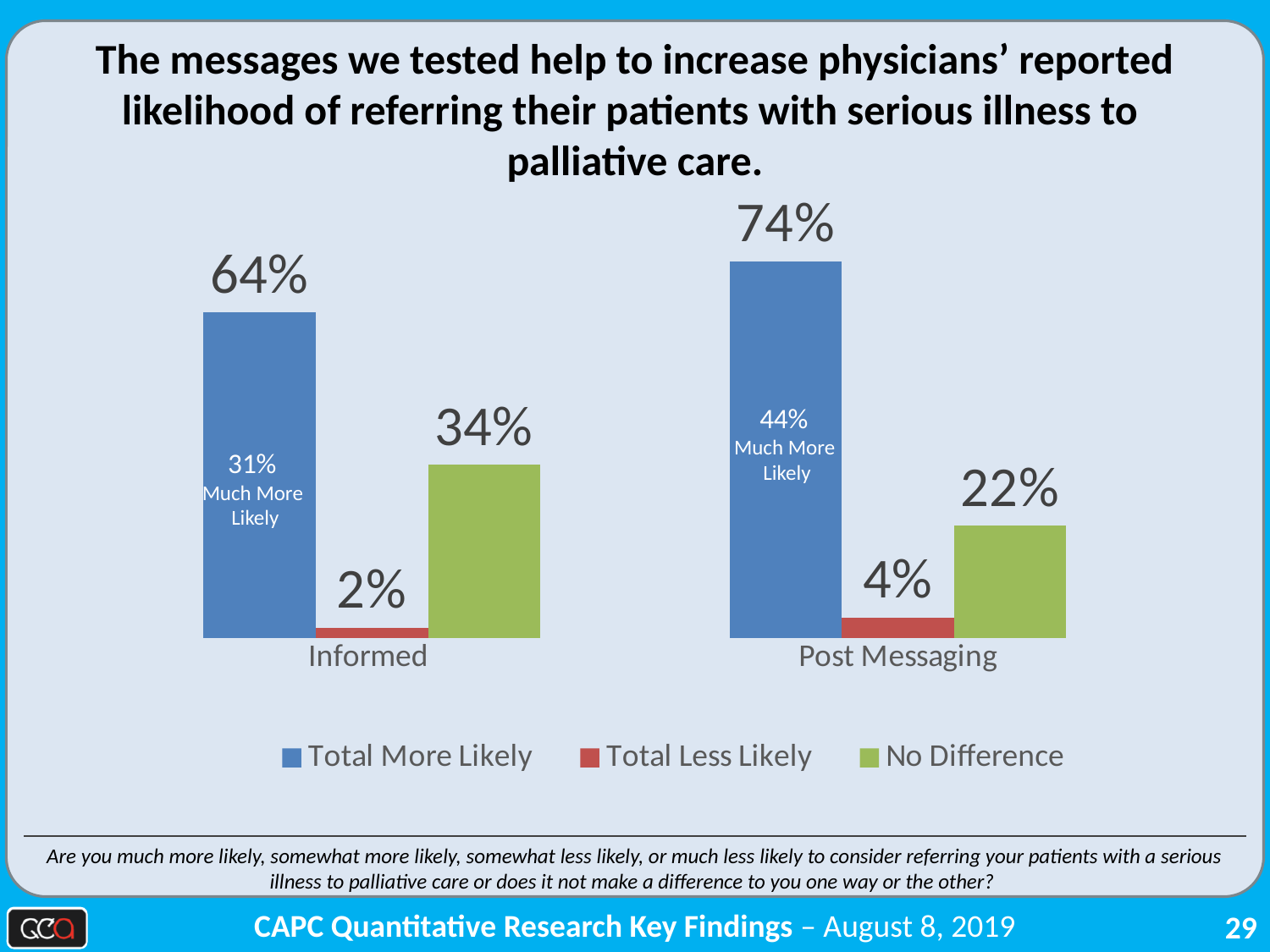
What is the difference between the Total More Likely values for Post Messaging and Informed? 10% What is the difference between the No Difference values for Informed and Post Messaging? 12% How many series does the legend list? 3 Which category has the higher Total More Likely value? Post Messaging How many categories are shown on the x axis? 2 What kind of chart is shown on the slide? Bar chart What is the value for Total More Likely in the Informed category? 64% Which series has the lowest value in the Informed category? Total Less Likely What is the value for No Difference in the Informed category? 34% What is the value for No Difference in the Post Messaging category? 22% What is the value for Total More Likely in the Post Messaging category? 74% What is the value for Total Less Likely in the Post Messaging category? 4%